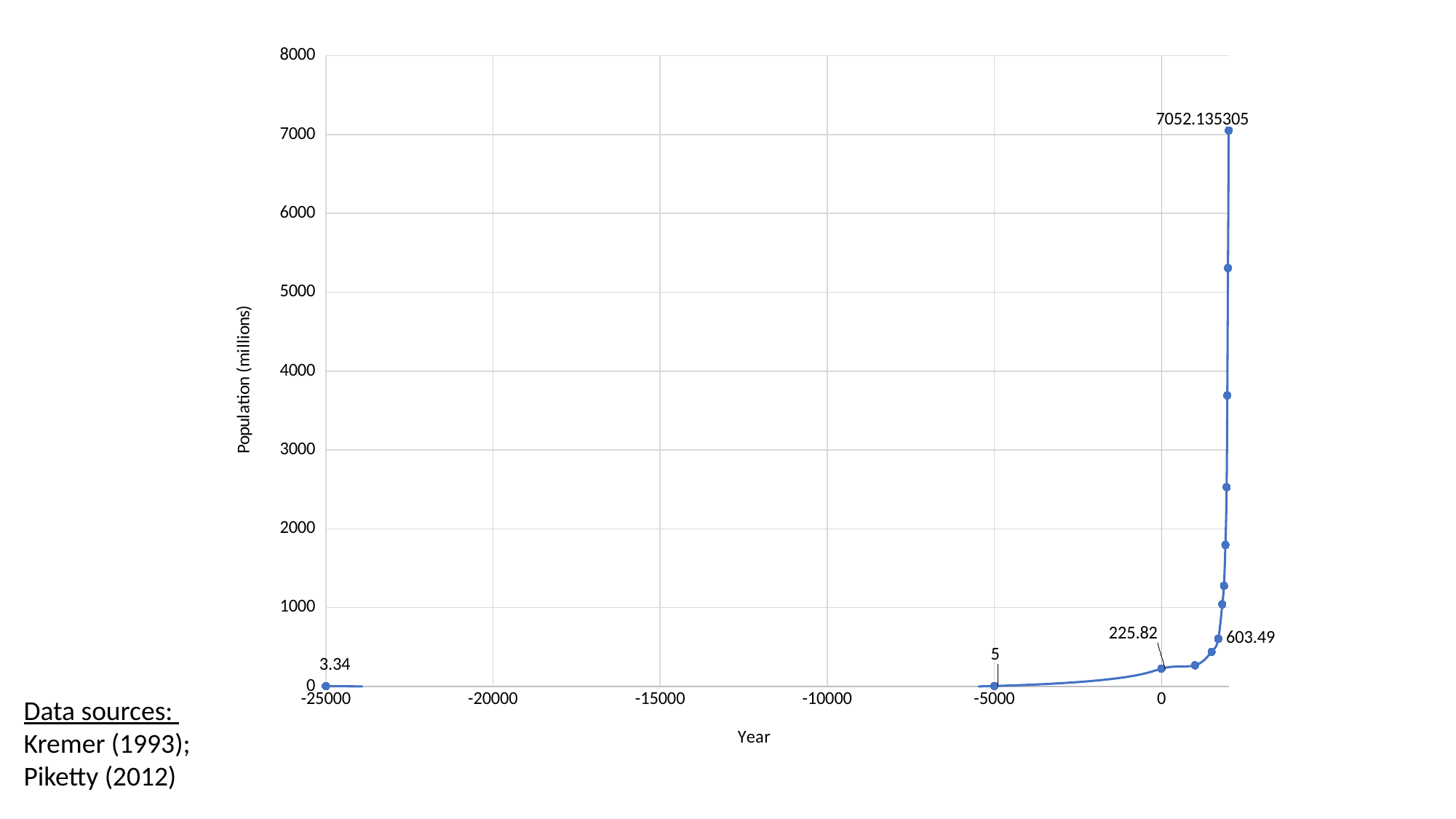
What is the difference between the population at year -5000 and the population at year -25000? 1.66 What kind of chart is shown on the slide? line chart What is the population value labelled at year -25000? 3.34 What is the population value labelled at year 0? 225.82 What is the population value labelled at year -5000? 5 What is the highest population value shown on the chart? 7052.135305 Is the second-highest point on the chart greater or less than 5000? greater What is the difference between the population at year 0 and the population at year -5000? 220.82 Do the population values rise or fall as the year increases along the x axis? rise What is the label of the vertical axis? Population (millions) Which is larger, the population at year 0 or the value labelled 603.49? 603.49 What is the lowest population value labelled on the chart? 3.34